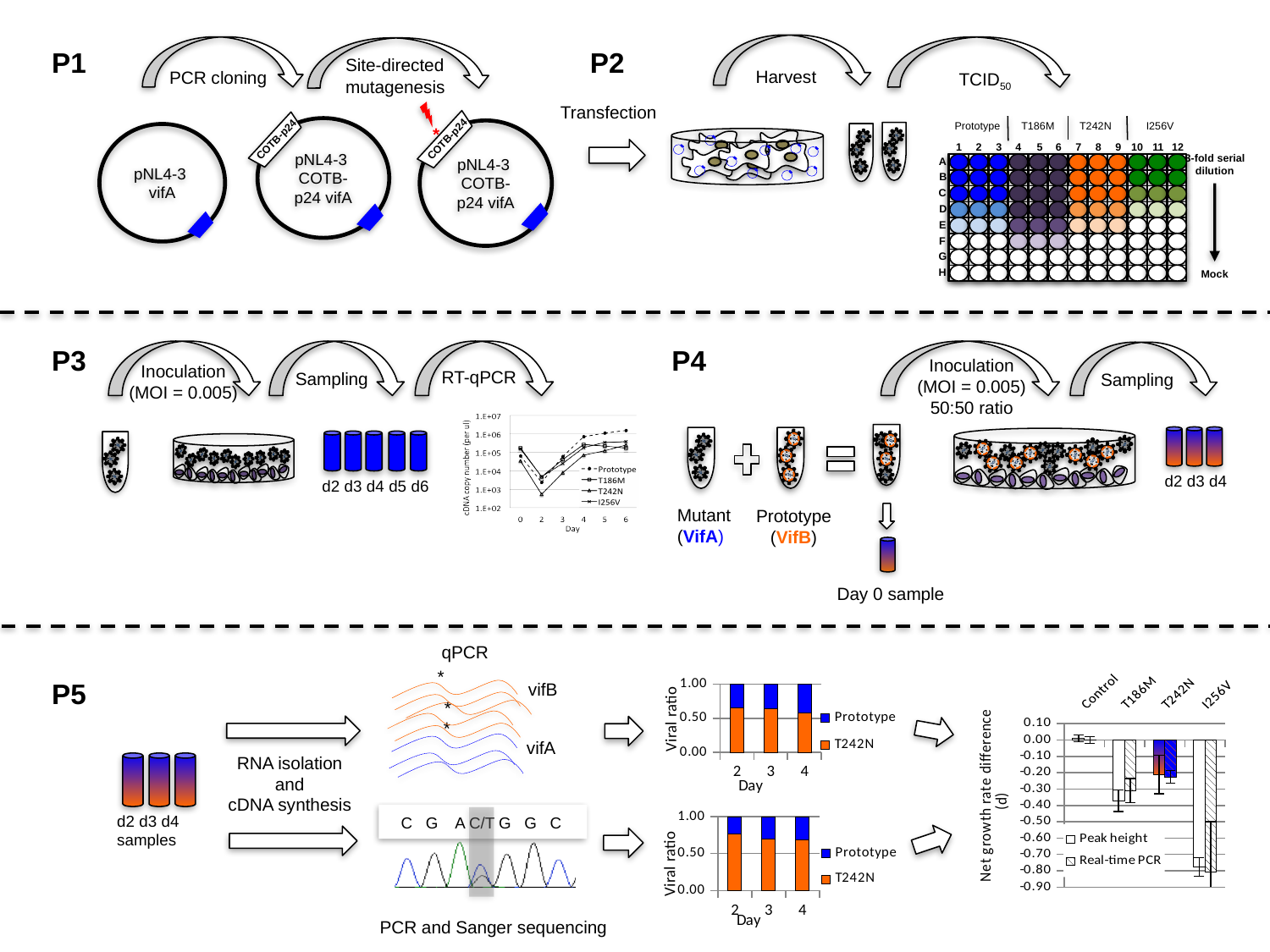
In the Net growth rate difference chart, which series does the legend list besides Peak height? Real-time PCR In the upper P5 Viral ratio chart, how many days are shown on the x axis? 3 In the Net growth rate difference chart, which category has the lowest Real-time PCR value? I256V In the P3 line chart, what is the label of the y axis? cDNA copy number (per ul) In the Net growth rate difference chart, how many categories are shown on the x axis? 4 In the upper P5 Viral ratio chart, how many series does the legend list? 2 In the upper P5 Viral ratio chart, what is the total of the stacked bar for day 3? 1.00 In the Net growth rate difference chart, is the Real-time PCR value for I256V greater or less than -0.50? less What kind of chart is the P3 chart of cDNA copy number versus Day? line chart In the lower P5 Viral ratio chart, is the T242N value for day 2 greater or less than 0.50? greater In the P3 line chart of cDNA copy number versus Day, how many series does the legend list? 4 What kind of chart is the lower P5 Viral ratio chart? bar chart